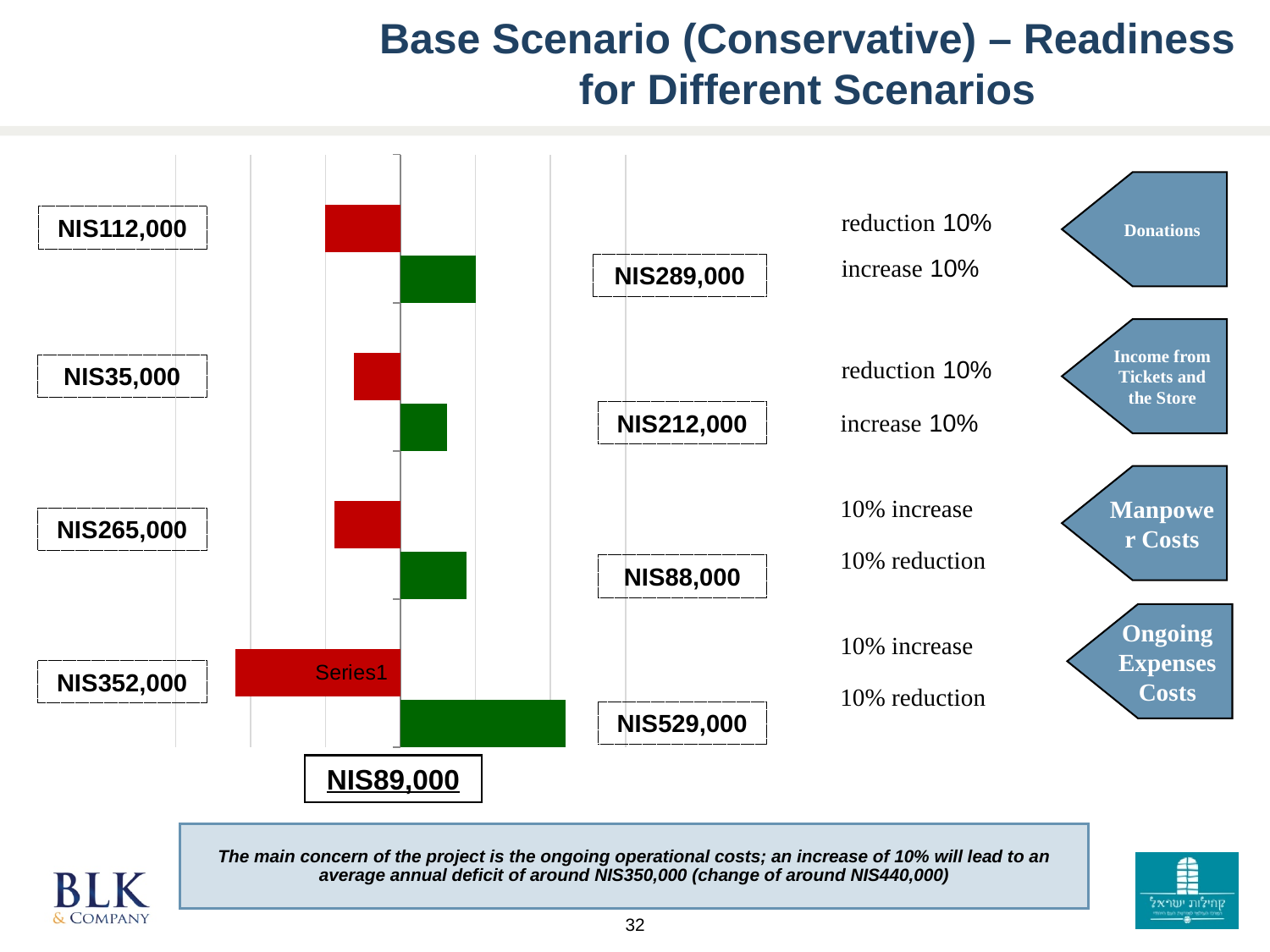
What value is shown for a 10% increase in Donations? NIS289,000 Which is larger: the value for a 10% increase in Donations or a 10% increase in Income from Tickets and the Store? Donations What value is shown for a 10% increase in Manpower Costs? NIS265,000 What value is shown for a 10% reduction in Ongoing Expenses Costs? NIS529,000 What value is shown for a 10% increase in Income from Tickets and the Store? NIS212,000 What value is shown for a 10% reduction in Donations? NIS112,000 What kind of chart is shown on the slide? bar chart How many categories (scenario groups) are shown in the chart? 4 What is the difference between the 10% increase value for Donations (NIS289,000) and for Income from Tickets and the Store (NIS212,000)? NIS77,000 Which category has the shortest red bar? Income from Tickets and the Store Which category has the longest green bar? Ongoing Expenses Costs What base value is shown underlined below the chart? NIS89,000